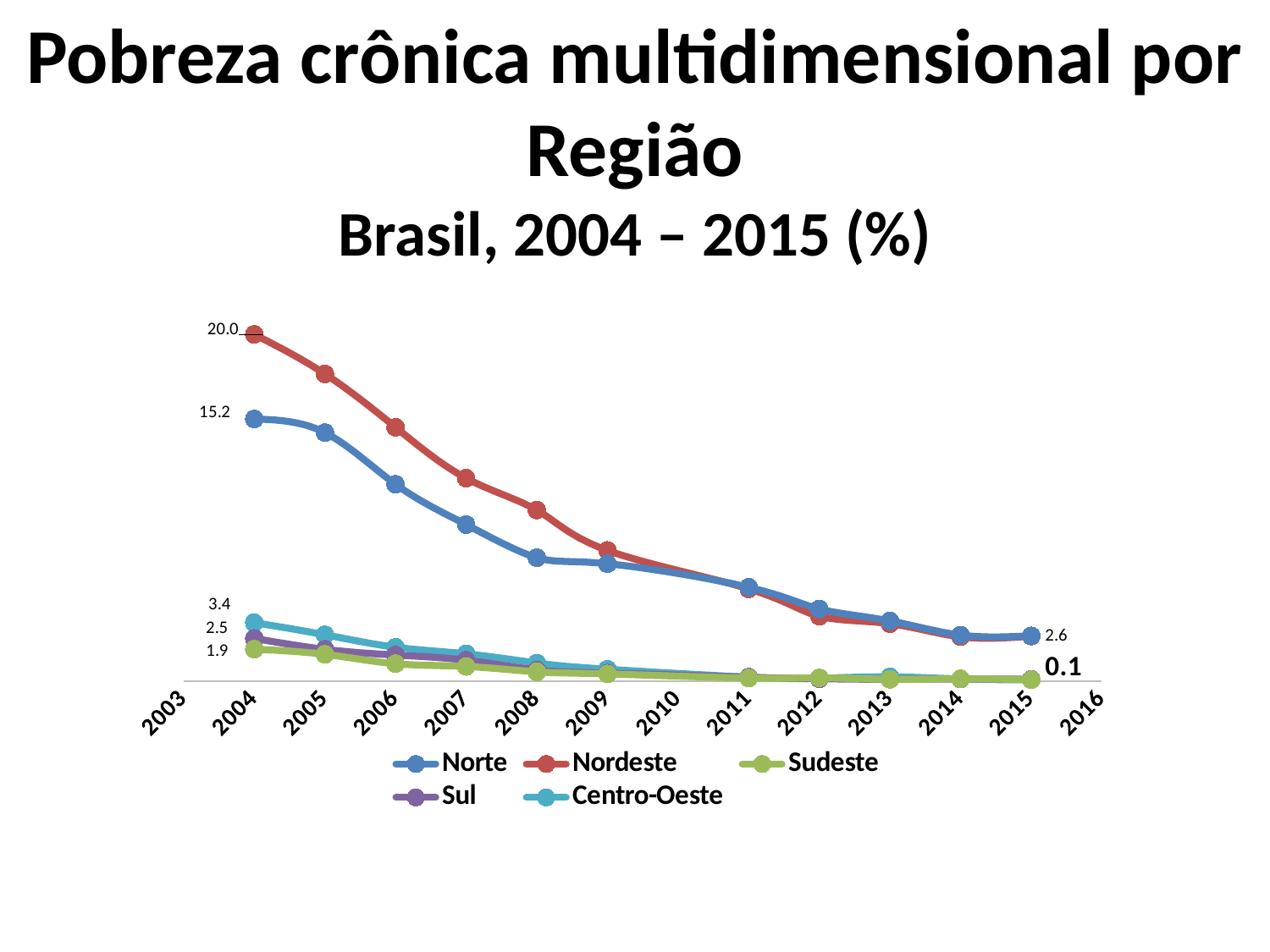
What is the value for Nordeste in 2004? 20.0 Which region has the highest value in 2004? Nordeste What is the value for Norte in 2015? 2.6 How many years are plotted for each series? 11 What kind of chart is shown on the slide? line chart What is the difference between the Nordeste and Norte values in 2004? 4.8 How many series does the legend list? 5 Which region has the lowest value in 2004? Sudeste What is the value for Sudeste in 2015? 0.1 What is the value for Centro-Oeste in 2004? 3.4 What is the value for Norte in 2004? 15.2 Does the Nordeste line rise or fall from 2004 to 2015? fall